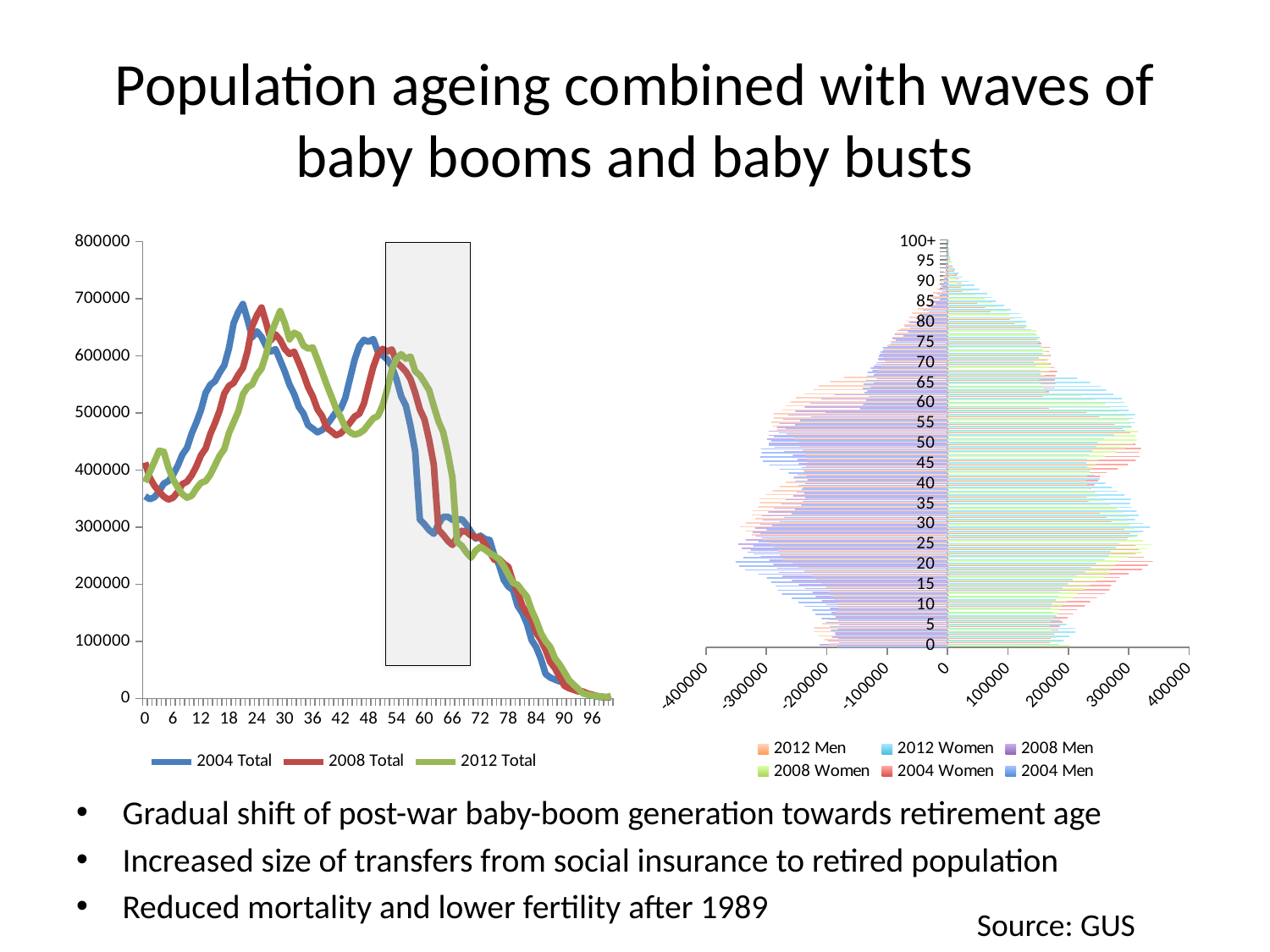
In the left line chart, is the peak value of the 2004 Total series greater or less than 600000? greater In the left line chart, is the value of the 2012 Total series at age 96 greater or less than 100000? less In the left line chart, at age 48, which series has the larger value: 2004 Total or 2012 Total? 2004 Total What kind of chart is the left chart on the slide? line chart In the left line chart, do the values of the 2008 Total series rise or fall between age 84 and age 96? fall What kind of chart is the right chart (the population pyramid) on the slide? bar chart How many series does the legend of the left line chart list? 3 In the right population pyramid chart, which series are shown on the negative (left) side of the horizontal axis? Men (2012 Men, 2008 Men, 2004 Men) In the left line chart, which series is plotted in green? 2012 Total In the left line chart, at age 30, which series has the larger value: 2004 Total or 2012 Total? 2012 Total In the left line chart, is the value of the 2004 Total series at age 0 greater or less than 400000? less How many series does the legend of the right population pyramid chart list? 6